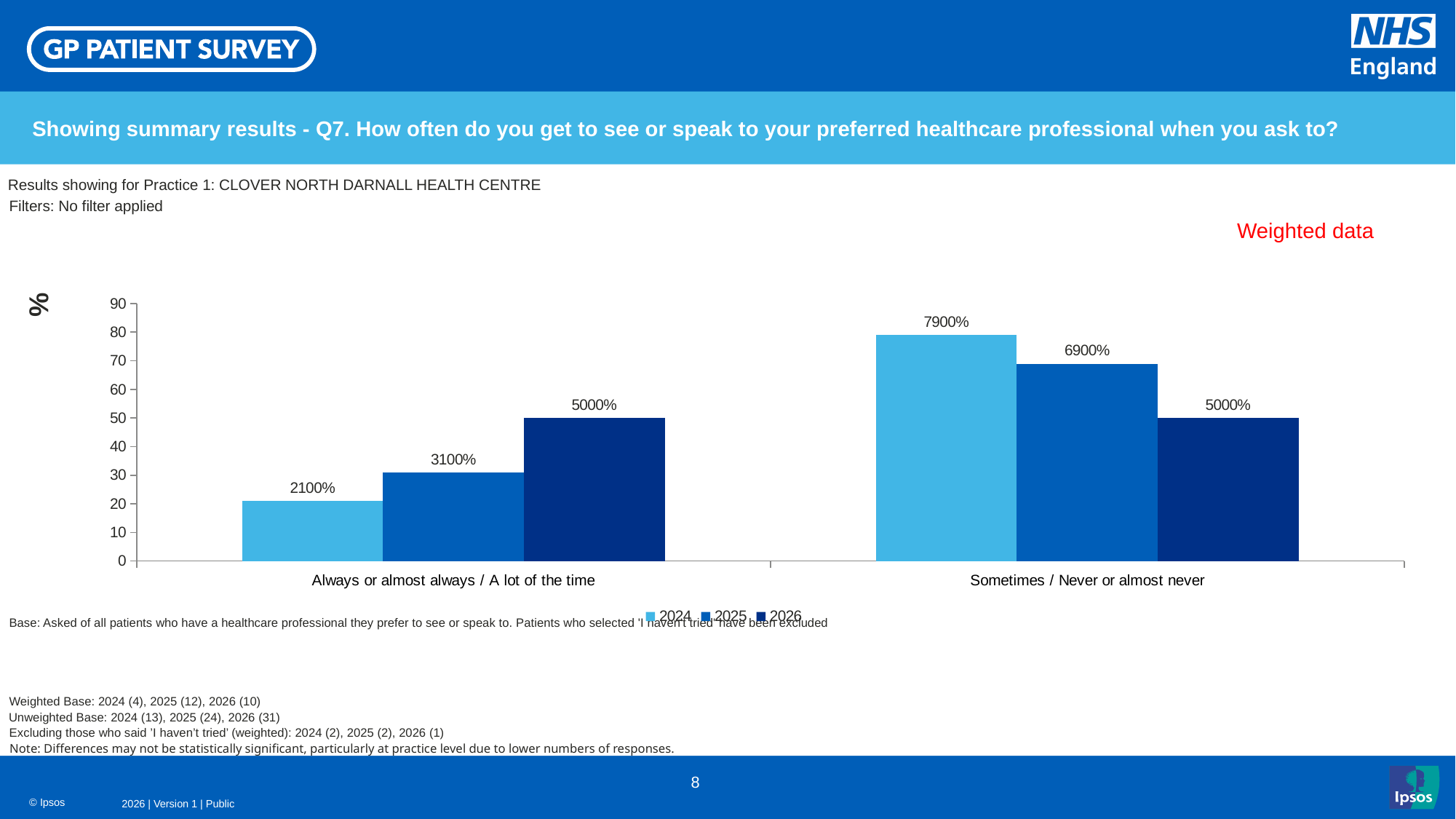
What is the data label for 2024 in the 'Always or almost always / A lot of the time' category? 2100% Is the 2025 bar for 'Always or almost always / A lot of the time' greater or less than 40 on the axis? less Which year has the lowest bar in the 'Always or almost always / A lot of the time' category? 2024 How many categories are shown on the x axis? 2 How many series does the legend list? 3 Which year has the highest bar in the 'Sometimes / Never or almost never' category? 2024 What is the data label for 2025 in the 'Sometimes / Never or almost never' category? 6900% What kind of chart is shown on the slide? Bar chart What is the data label for 2024 in the 'Sometimes / Never or almost never' category? 7900% Is the 2024 bar for 'Sometimes / Never or almost never' greater or less than 70 on the axis? greater Which is larger: the 2026 bar for 'Always or almost always / A lot of the time' or the 2026 bar for 'Sometimes / Never or almost never'? They are equal What is the data label for 2026 in the 'Always or almost always / A lot of the time' category? 5000%